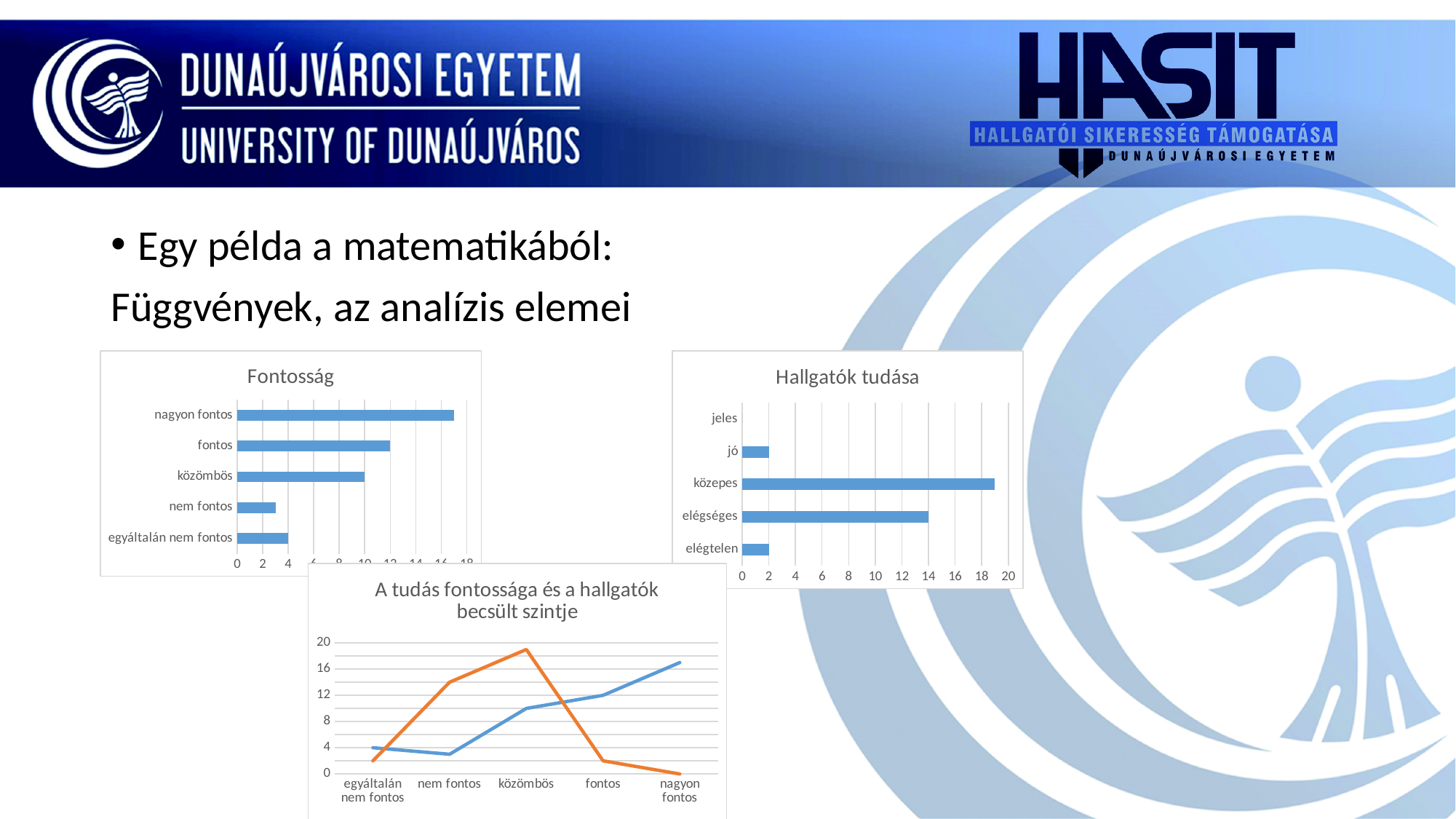
In the 'Fontosság' chart, what is the value for 'közömbös'? 10 In the 'Hallgatók tudása' chart, which is larger, the value for 'elégséges' or the value for 'elégtelen'? elégséges In the 'Hallgatók tudása' chart, is the value for 'közepes' greater or less than 18? greater How many categories does the 'Fontosság' chart show? 5 In the 'Hallgatók tudása' chart, what is the value for 'jó'? 2 In the 'Fontosság' chart, is the value for 'nagyon fontos' greater or less than 16? greater In the 'Fontosság' chart, which category has the highest value? nagyon fontos What type of chart is 'A tudás fontossága és a hallgatók becsült szintje'? line chart In the 'Hallgatók tudása' chart, what is the value for 'elégséges'? 14 In the 'Hallgatók tudása' chart, which category has the highest value? közepes In the 'Fontosság' chart, what is the value for 'fontos'? 12 What type of chart is the 'Fontosság' chart? bar chart